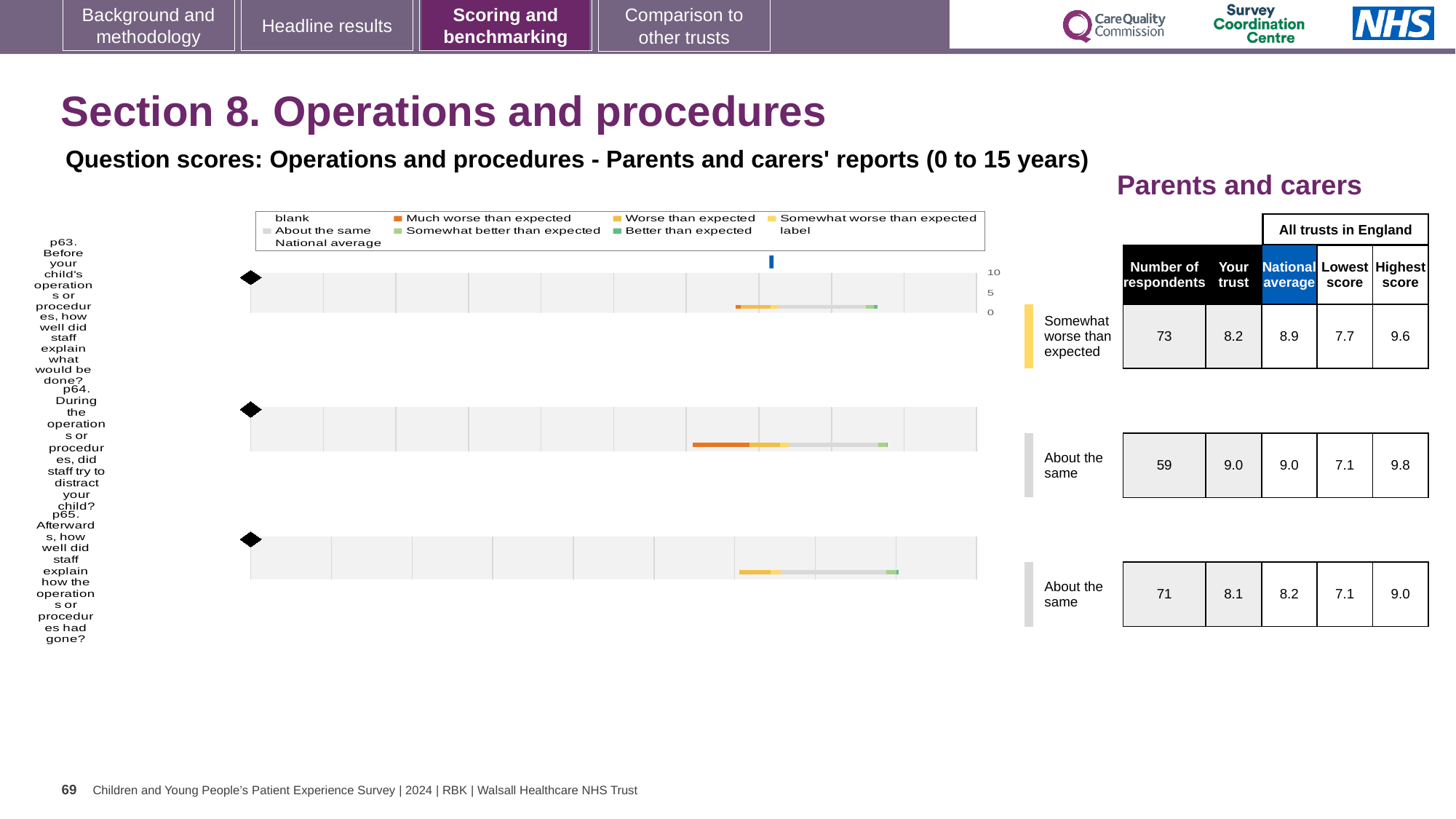
Which legend entry is shown in orange in the chart legend? Much worse than expected How many respondents answered p65 (Afterwards, how well did staff explain how the operations or procedures had gone?)? 71 What kind of chart is used to show the question scores on this slide? bar chart How many questions (categories) are plotted in the chart? 3 For p63, which is larger: the 'Your trust' score or the national average? National average Which question has the highest 'Your trust' score? p64 Which question has the lowest 'Your trust' score? p65 What is the highest tick value shown on the chart's axis? 10 What is the difference between the national average and the 'Your trust' score for p63? 0.7 What is the national average score for p64 (During the operations or procedures, did staff try to distract your child?)? 9.0 What is the 'Your trust' score for p63 (Before your child's operations or procedures, how well did staff explain what would be done?)? 8.2 What benchmark category is p63 assigned to? Somewhat worse than expected